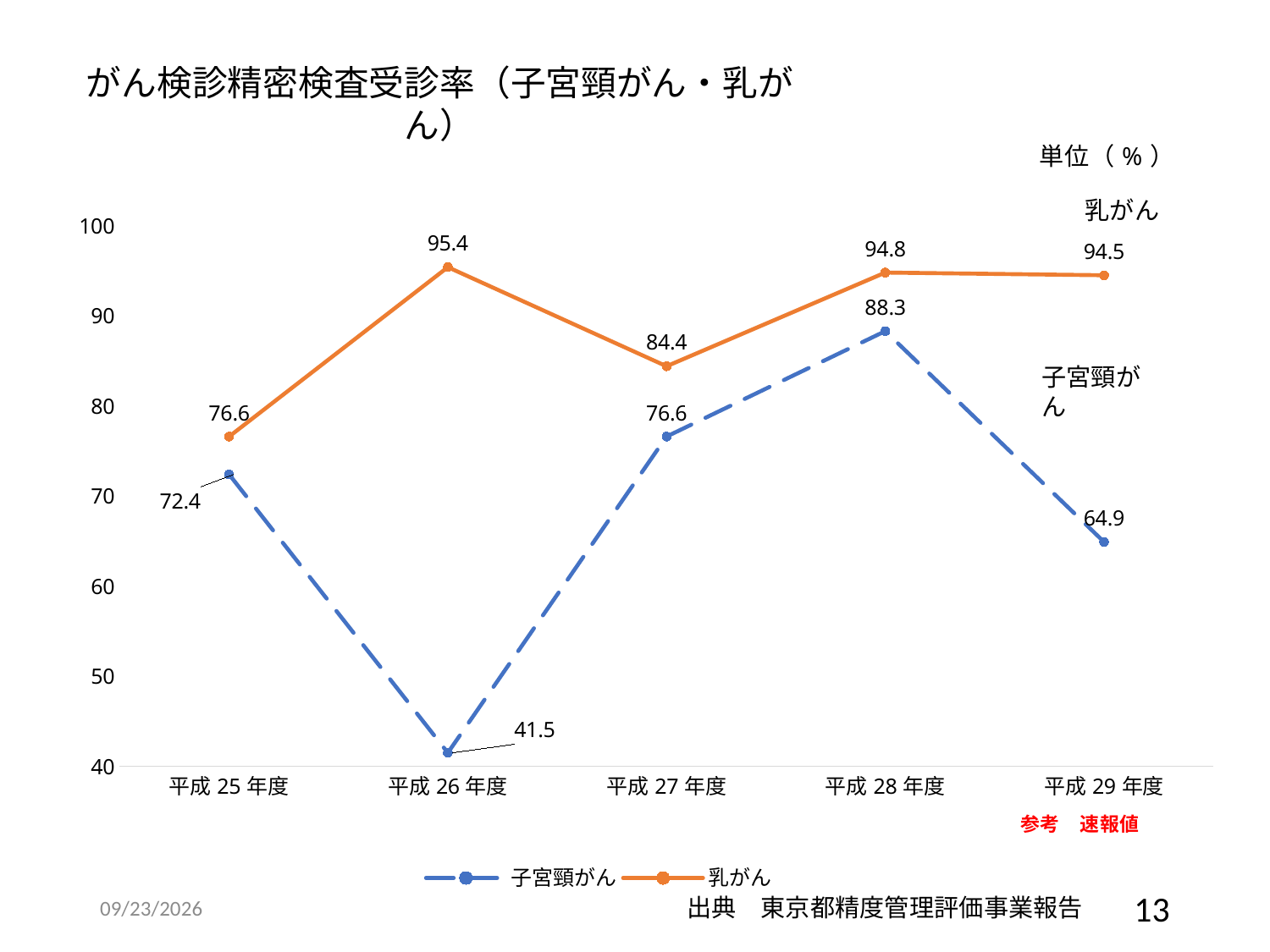
In which year is the 子宮頸がん value lowest? 平成26年度 What is the difference between the 乳がん and 子宮頸がん values in 平成26年度? 53.9 What is the value for 乳がん in 平成27年度? 84.4 What is the value for 乳がん in 平成26年度? 95.4 How many series does the legend list? 2 Which series has the larger value in 平成28年度, 乳がん or 子宮頸がん? 乳がん What is the value for 子宮頸がん in 平成29年度? 64.9 In which year is the 乳がん value lowest? 平成25年度 What is the value for 子宮頸がん in 平成26年度? 41.5 How many years are shown on the x axis? 5 In which year is the 子宮頸がん value highest? 平成28年度 What kind of chart is shown on the slide? Line chart